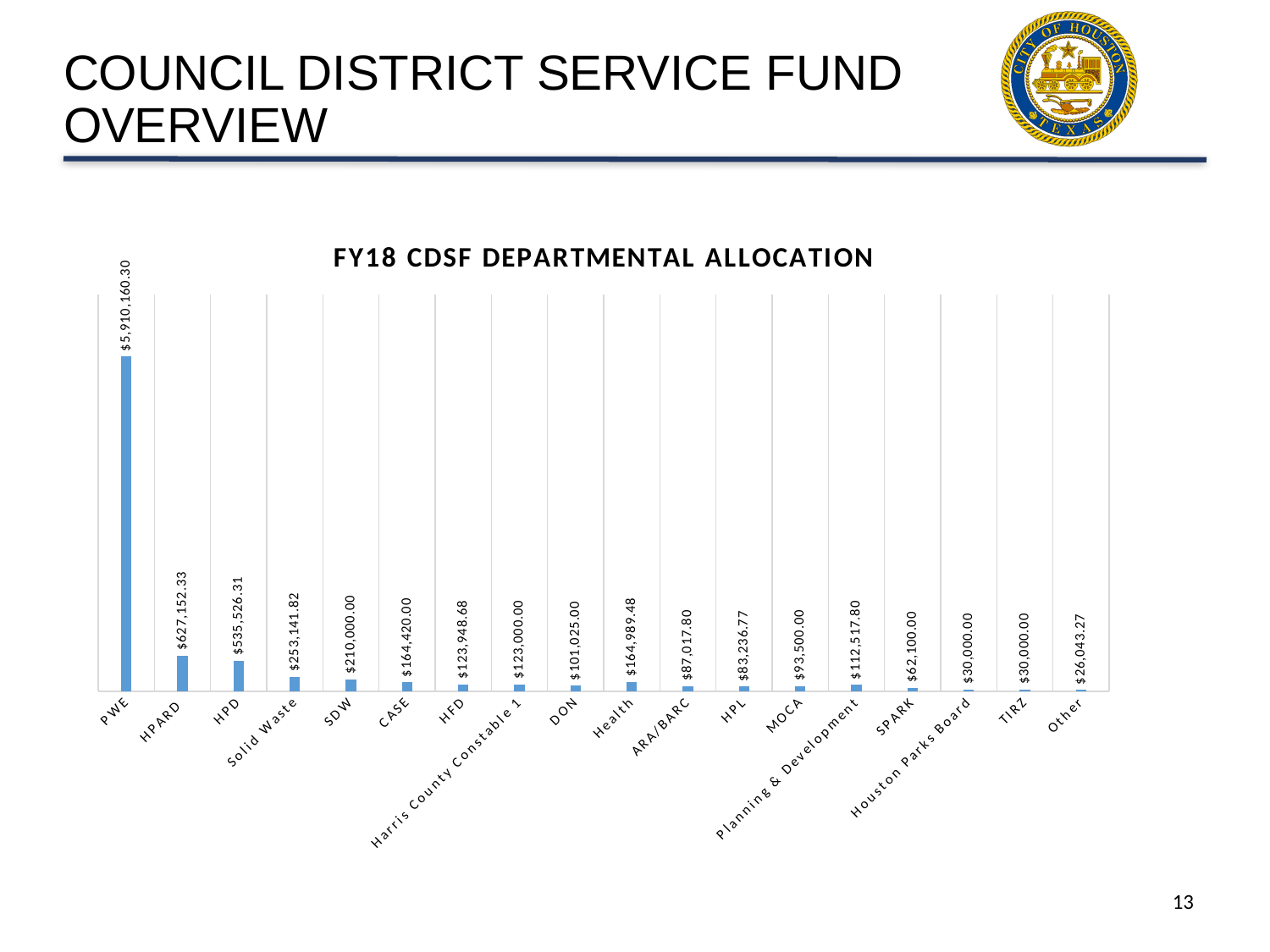
How many departments or categories are shown in the chart? 18 Which category has the lowest FY18 CDSF allocation? Other Which department has the highest FY18 CDSF allocation? PWE What is the FY18 CDSF allocation for PWE? $5,910,160.30 What is the difference between the allocations for SDW and CASE? $45,580.00 What is the allocation shown for Harris County Constable 1? $123,000.00 What type of chart is used to show the FY18 CDSF departmental allocation? Bar chart What is the difference between the allocations for HPARD and HPD? $91,626.02 Which has a larger allocation, Solid Waste or SDW? Solid Waste What is the title of the chart on the slide? FY18 CDSF DEPARTMENTAL ALLOCATION What is the allocation shown for Planning & Development? $112,517.80 What is the allocation shown for HPARD? $627,152.33